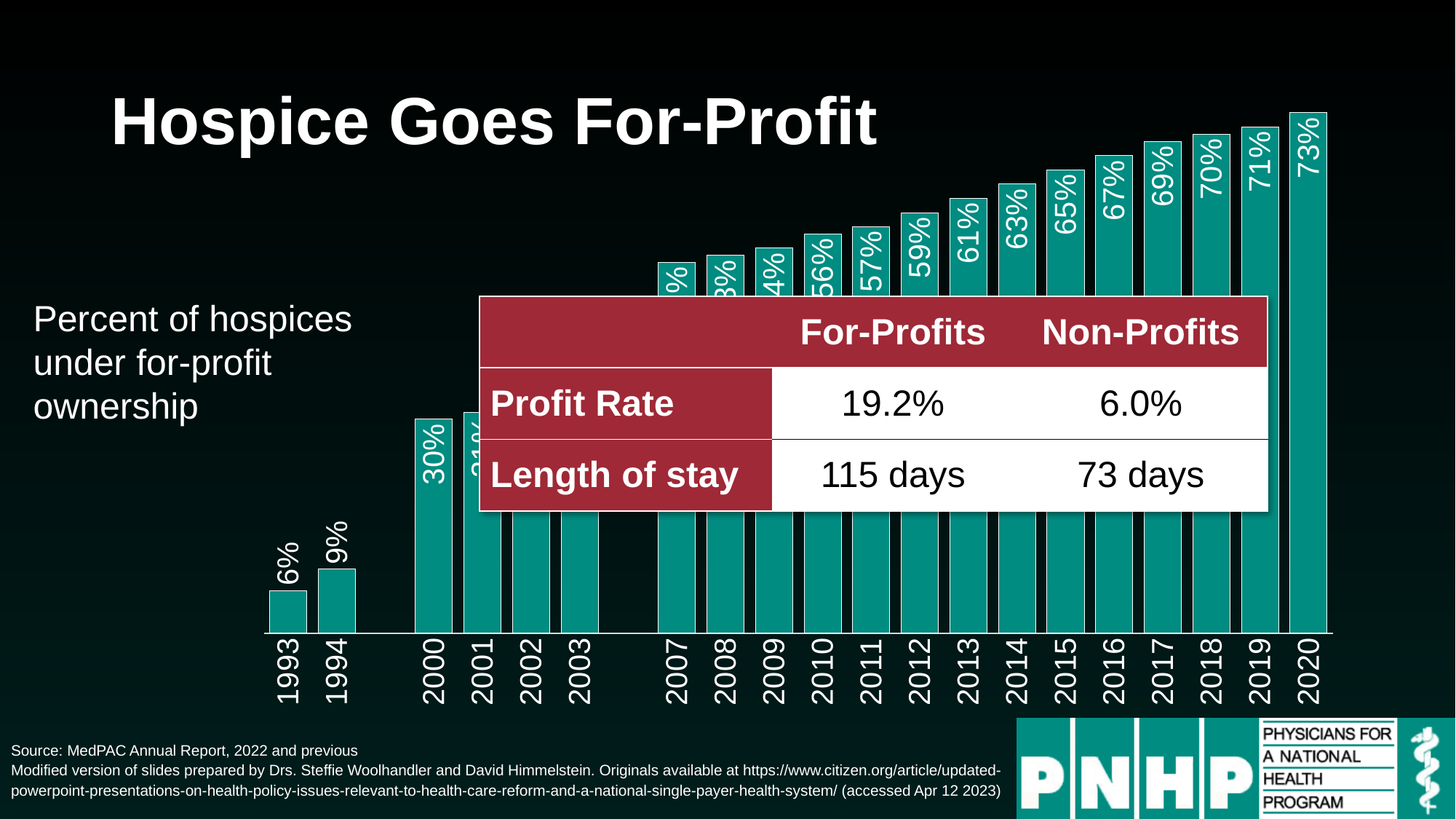
What is the value for 2015? 65% What is the value for 2020? 73% Which year has the lowest value? 1993 How many bars are shown in the chart? 20 Which year has the highest value? 2020 Which is larger, the value for 2014 or the value for 2012? 2014 What is the difference between the values for 2020 and 1993? 67 percentage points What is the value for 2010? 56% What is the value for 2000? 30% Do the values rise or fall from 1993 to 2020? Rise What kind of chart is shown on the slide? Bar chart What is the value for 1993? 6%